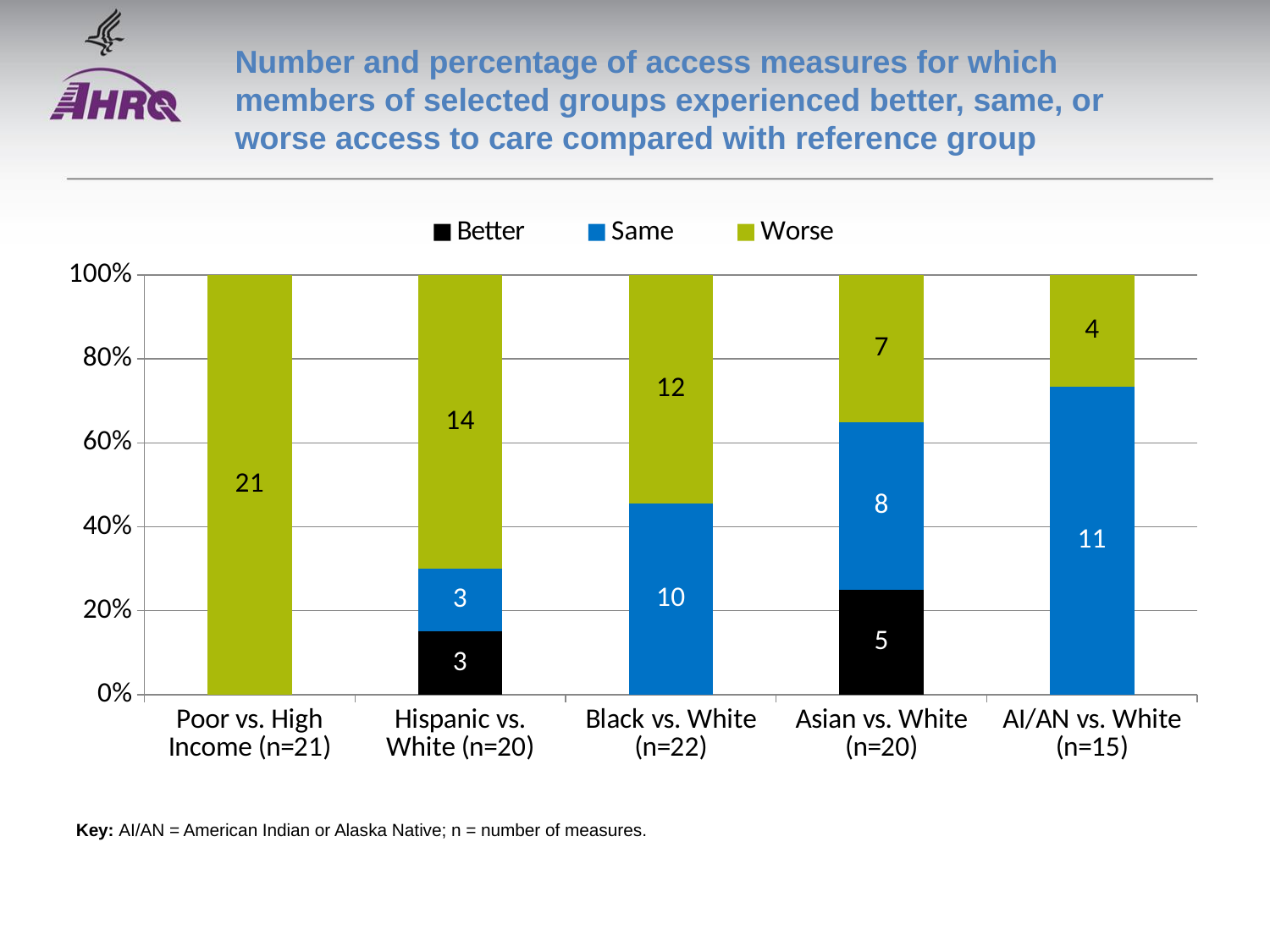
What is the Better value for Asian vs. White (n=20)? 5 What is the Same value for Black vs. White (n=22)? 10 Which group has the lowest Worse value? AI/AN vs. White (n=15) What is the Worse value for AI/AN vs. White (n=15)? 4 For Asian vs. White (n=20), which is larger, the Same value or the Worse value? Same What is the Worse value for Poor vs. High Income (n=21)? 21 How many groups are shown along the x axis? 5 What is the total of the stacked bar for Hispanic vs. White (n=20)? 20 What is the difference between the Worse and Same values for Hispanic vs. White (n=20)? 11 What kind of chart is shown on the slide? stacked bar chart How many series does the legend list? 3 Which group has the highest Worse value? Poor vs. High Income (n=21)